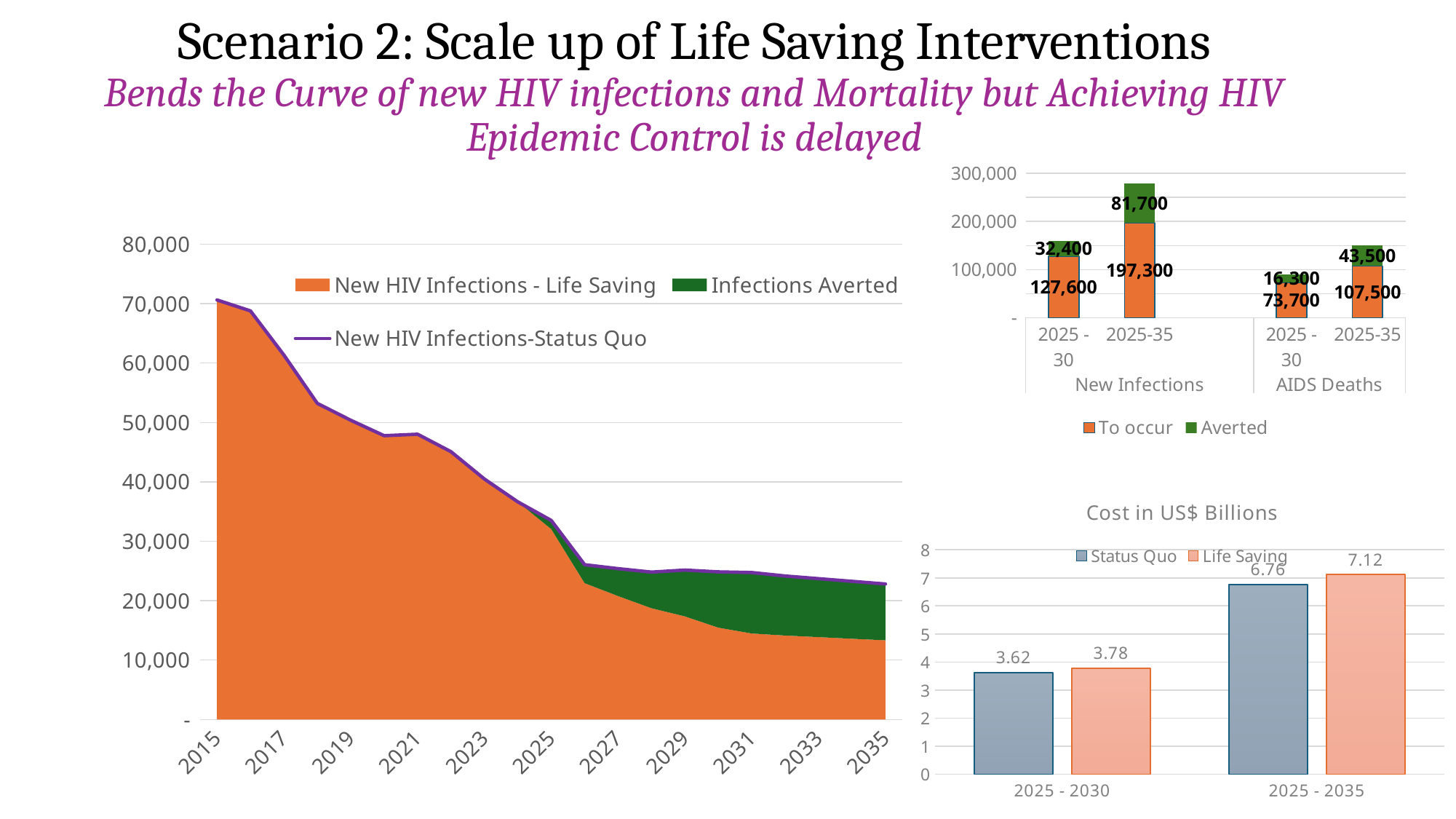
In the large area chart on the left, is the New HIV Infections-Status Quo value for 2015 greater or less than 60,000? greater In the top-right stacked bar chart, what is the total of the New Infections 2025-30 bar? 160,000 In the top-right stacked bar chart, what is the 'Averted' value for AIDS Deaths in 2025-35? 43,500 In the top-right stacked bar chart, what is the 'To occur' value for New Infections in 2025-35? 197,300 In the 'Cost in US$ Billions' chart, which bar has the lowest value? Status Quo, 2025 - 2030 (3.62) In the 'Cost in US$ Billions' chart, what is the Life Saving value for 2025 - 2035? 7.12 In the top-right stacked bar chart, what is the total of the AIDS Deaths 2025-35 bar? 151,000 In the top-right stacked bar chart, how many series does the legend list? 2 In the large area chart on the left, how many series does the legend list? 3 In the large area chart on the left, do new HIV infections rise or fall from 2015 to 2035? fall In the 'Cost in US$ Billions' chart, what is the difference between the Life Saving and Status Quo values for 2025 - 2035? 0.36 In the 'Cost in US$ Billions' chart, which is larger for 2025 - 2030: Status Quo or Life Saving? Life Saving